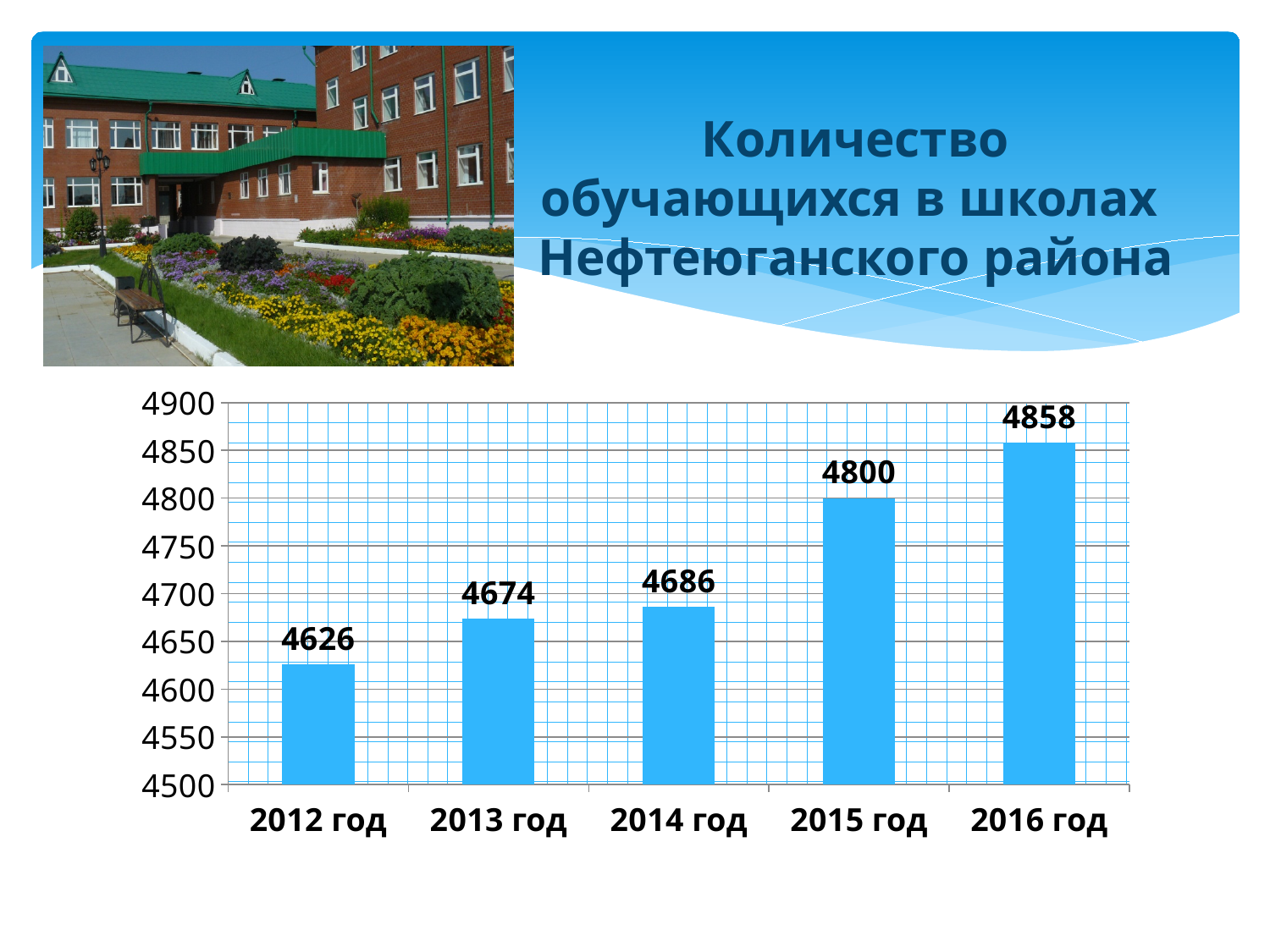
Is the value for 2015 год greater or less than 4750? greater Do the values rise or fall from 2012 год to 2016 год? rise What is the value for 2014 год? 4686 How many years are shown on the chart? 5 What is the difference between the values for 2016 год and 2015 год? 58 Which year has the highest value? 2016 год What is the value for 2012 год? 4626 What kind of chart is shown on the slide? bar chart What is the difference between the values for 2013 год and 2012 год? 48 Which is larger, the value for 2014 год or the value for 2013 год? 2014 год What is the value for 2015 год? 4800 Which year has the lowest value? 2012 год